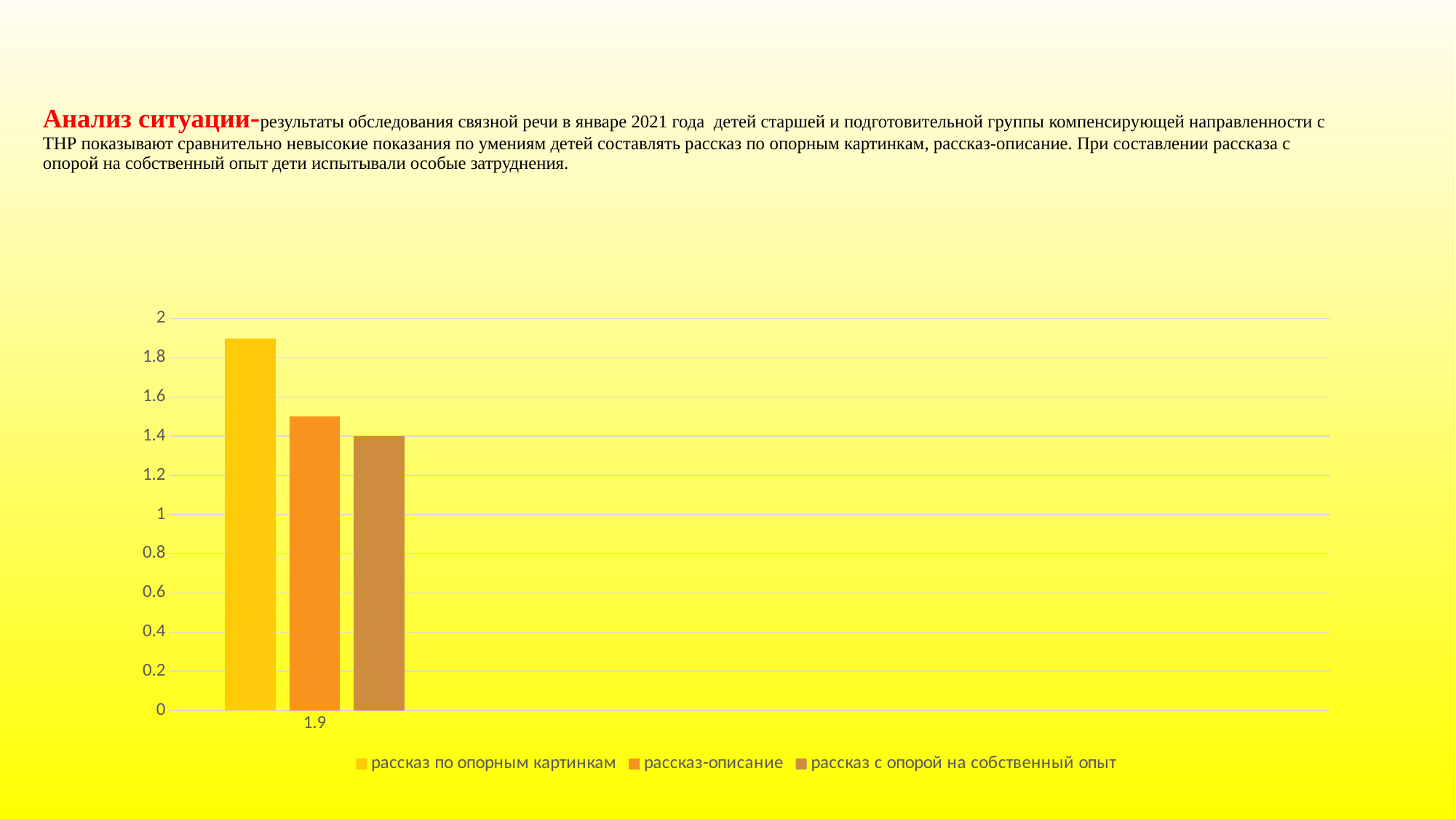
What kind of chart is shown on the slide? bar chart Which series has the lowest bar? рассказ с опорой на собственный опыт How many series does the legend list? 3 Is the value for 'рассказ-описание' greater or less than 1.6? less What colour is the bar for 'рассказ-описание'? orange Is the value for 'рассказ по опорным картинкам' greater or less than 1.8? greater Is the value for 'рассказ-описание' greater or less than 1.4? greater Which is larger: the value for 'рассказ по опорным картинкам' or for 'рассказ-описание'? рассказ по опорным картинкам Which series has the highest bar? рассказ по опорным картинкам What is the value for the series 'рассказ с опорой на собственный опыт'? 1.4 What label is shown on the x axis under the bars? 1.9 How many categories are shown on the x axis? 1